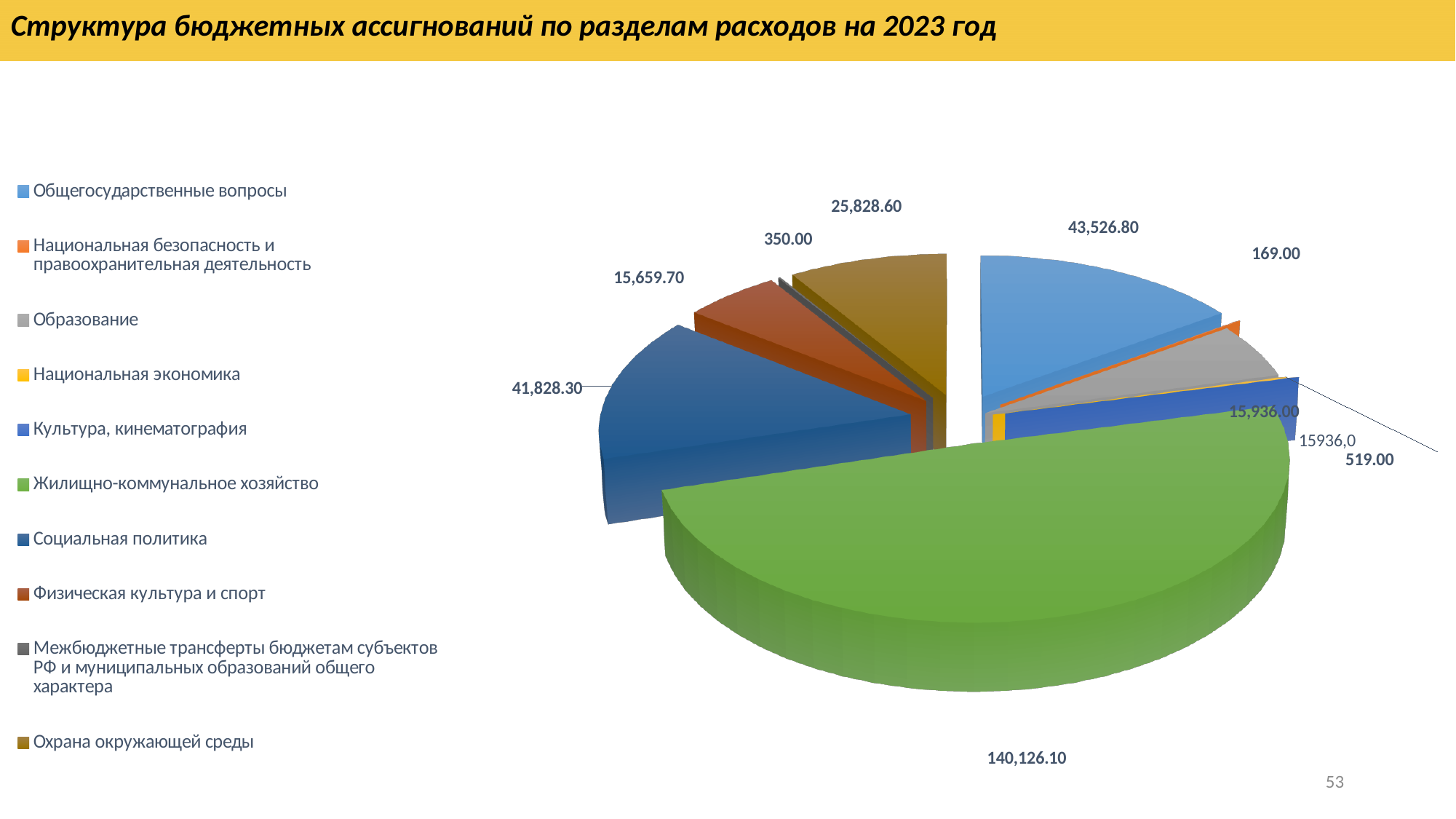
How many categories does the legend list? 10 Which category has the largest slice of the pie? Жилищно-коммунальное хозяйство What is the value for Охрана окружающей среды? 25,828.60 What is the value for Общегосударственные вопросы? 43,526.80 Which is larger: the value for Социальная политика or the value for Охрана окружающей среды? Социальная политика What is the value for Жилищно-коммунальное хозяйство? 140,126.10 What is the difference between the values for Общегосударственные вопросы and Социальная политика? 1,698.50 What is the value for Социальная политика? 41,828.30 What is the value for Национальная безопасность и правоохранительная деятельность? 169.00 What kind of chart is shown on the slide? pie chart What is the value for Физическая культура и спорт? 15,659.70